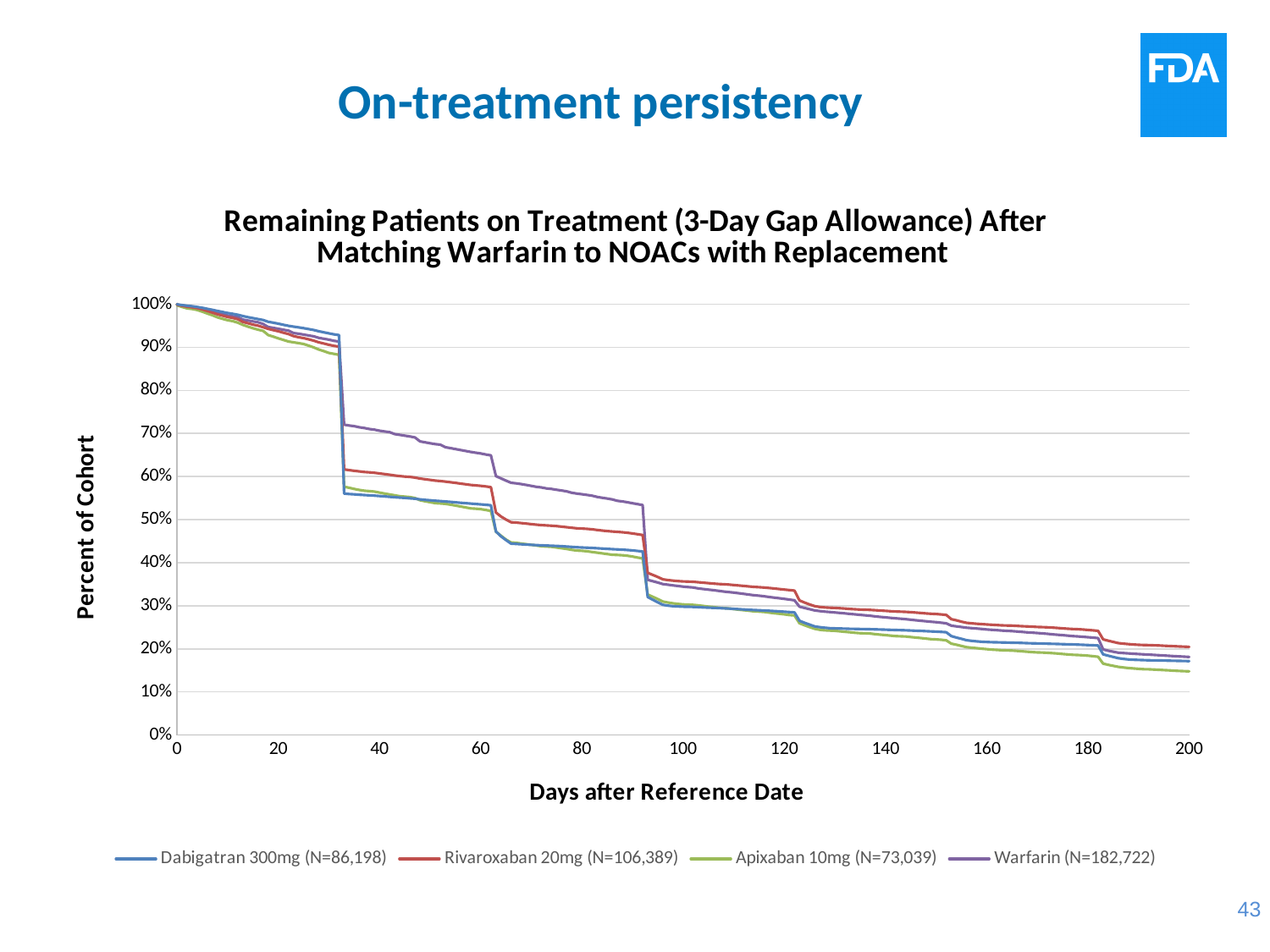
What is the value for Warfarin at day 0? 100% Is the value for Apixaban 10mg at day 200 greater or less than 20%? less What kind of chart is shown on the slide? line chart What is the label of the y axis? Percent of Cohort At day 80, which is larger: the value for Rivaroxaban 20mg or the value for Dabigatran 300mg? Rivaroxaban 20mg Is the value for Warfarin at day 50 greater or less than 60%? greater Do the values rise or fall as days after reference date increase? fall Which series has the highest value at day 50? Warfarin (N=182,722) How many series does the legend list? 4 Which series has the lowest value at day 200? Apixaban 10mg (N=73,039) Is the value for Rivaroxaban 20mg at day 80 greater or less than 50%? less What is the title of the chart? Remaining Patients on Treatment (3-Day Gap Allowance) After Matching Warfarin to NOACs with Replacement